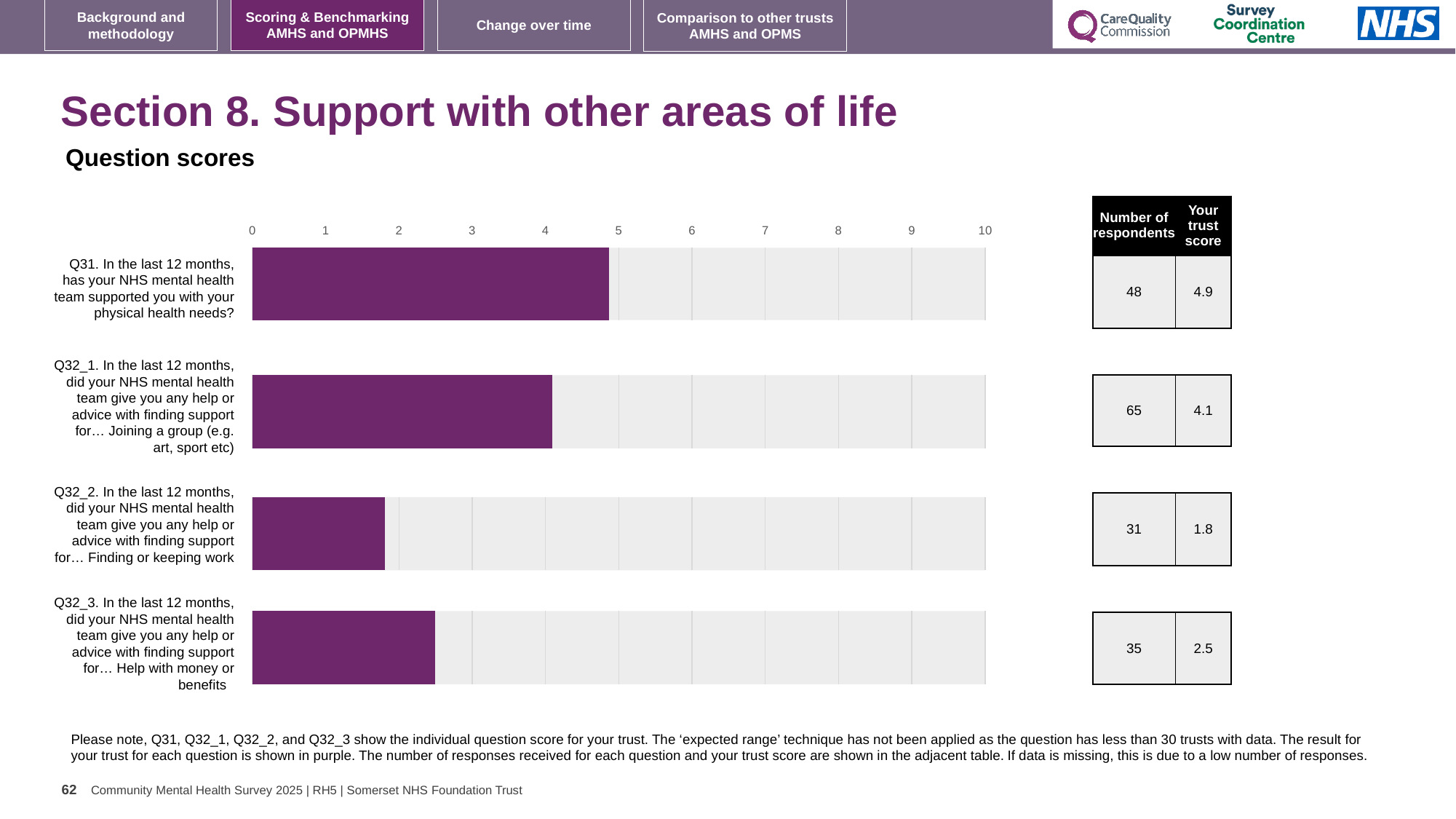
What is the trust score for Q32_2 (help or advice with finding or keeping work)? 1.8 Which question has the lowest trust score? Q32_2 How many respondents answered Q32_1 (joining a group)? 65 How many questions are plotted in the chart? 4 What is the difference between the trust scores for Q31 and Q32_1? 0.8 Which has the larger trust score, Q32_2 or Q32_3? Q32_3 What is the trust score for Q32_3 (help with money or benefits)? 2.5 What is the maximum value shown on the chart's axis? 10 Which question has the highest trust score? Q31 What is the trust score for Q31 (supported you with your physical health needs)? 4.9 What type of chart is shown on the slide? bar chart Is the trust score for Q32_1 greater or less than 3? greater